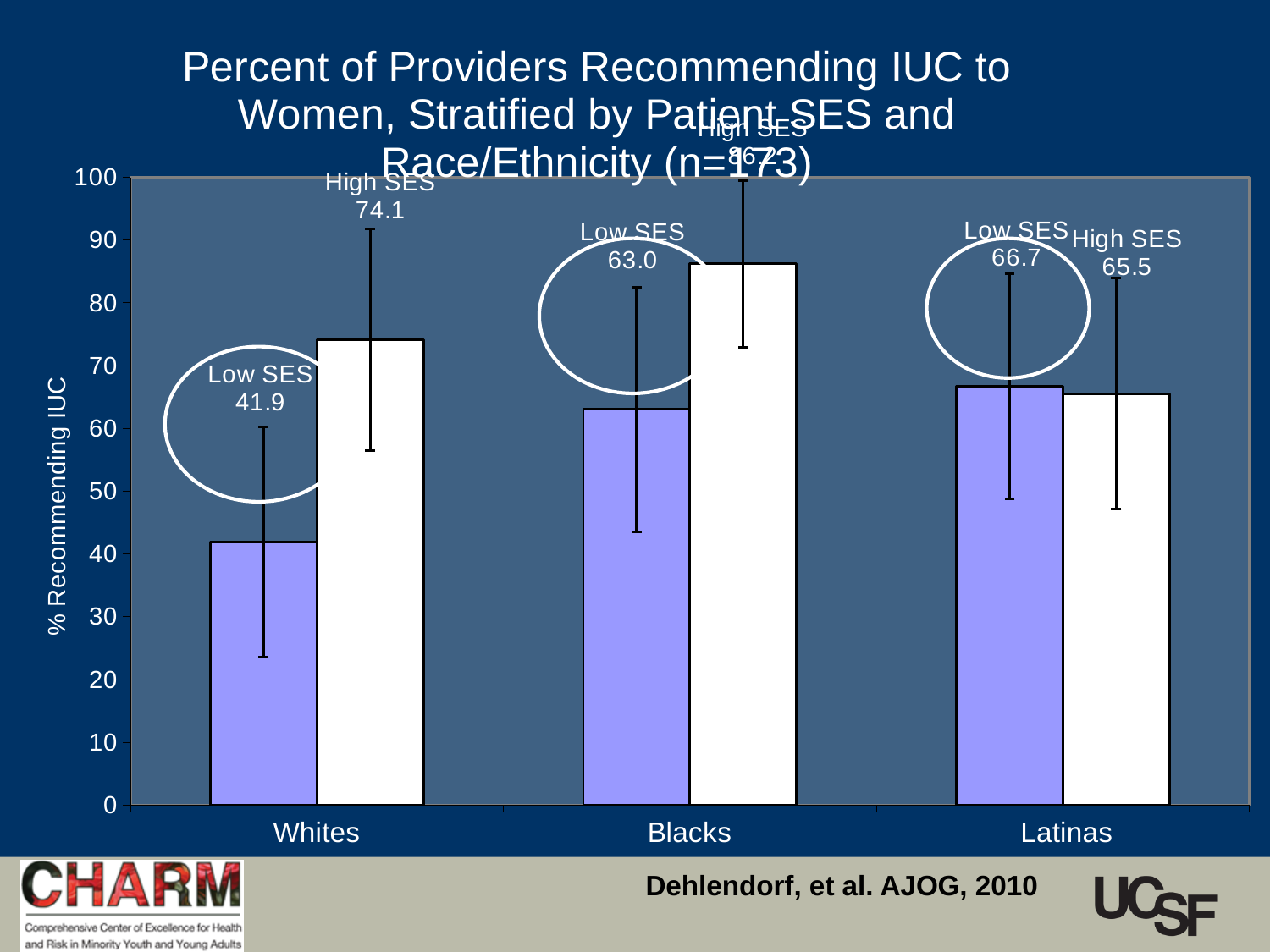
What is the difference between the High SES and Low SES values for Whites? 32.2 What is the High SES value for Whites? 74.1 Which race/ethnicity group has the lowest Low SES value? Whites Is the High SES value for Blacks greater or less than 80? greater What is the High SES value for Latinas? 65.5 What kind of chart is shown on the slide? bar chart What is the label on the y axis? % Recommending IUC How many race/ethnicity categories are shown on the x axis? 3 Which race/ethnicity group has the highest Low SES value? Latinas What is the Low SES value for Blacks? 63.0 What is the Low SES value for Latinas? 66.7 What is the Low SES value for Whites? 41.9